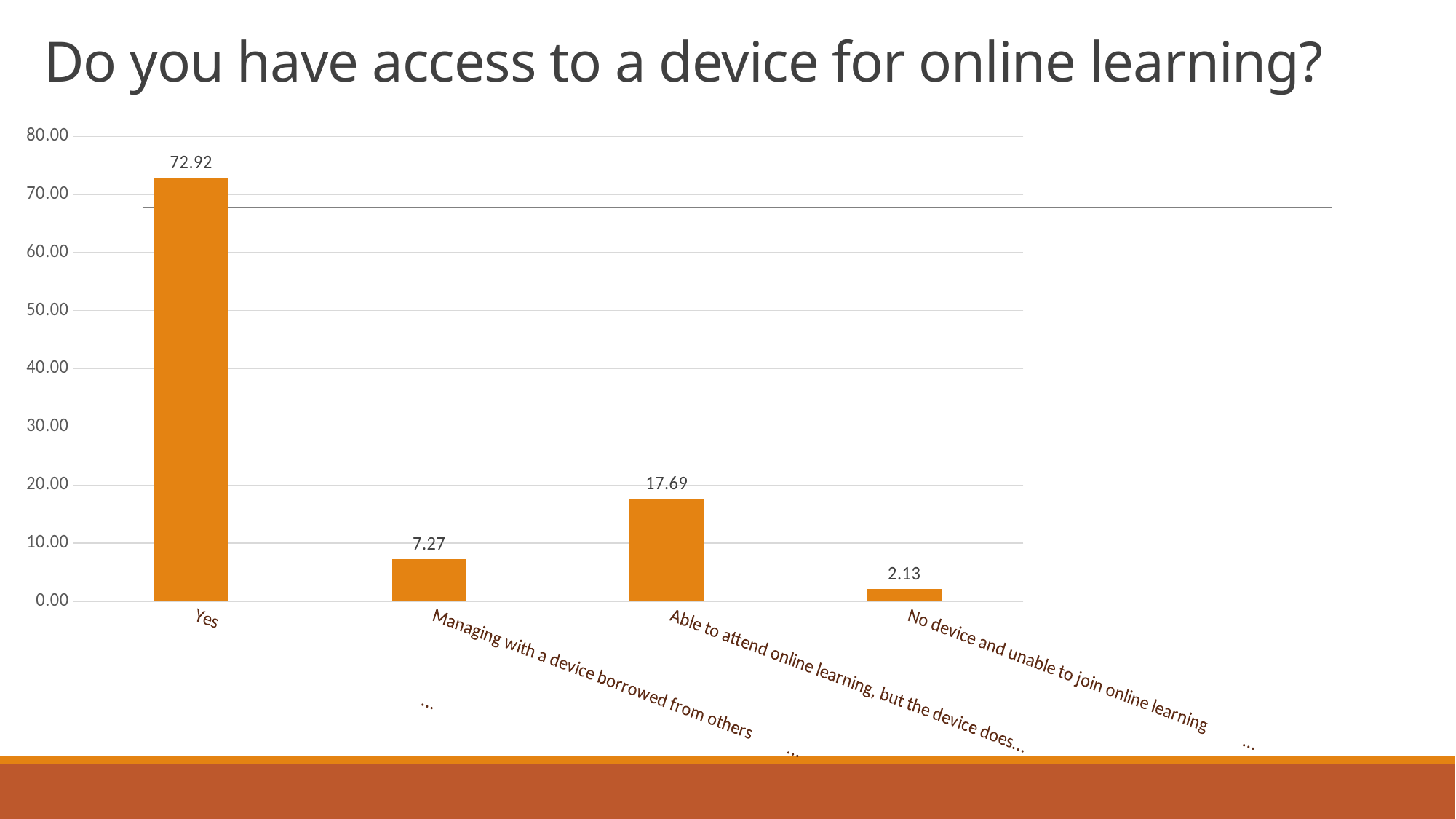
What is the value for "Managing with a device borrowed from others"? 7.27 Which category has the highest value? Yes What is the value for the "Yes" category? 72.92 Is the value for "Yes" greater or less than 70.00? greater What kind of chart is shown on the slide? Bar chart What is the difference between the values for "Yes" and "No device and unable to join online learning"? 70.79 Which is larger: the value for "Managing with a device borrowed from others" or the value for "Able to attend online learning, but the device does..."? Able to attend online learning, but the device does... What is the value for "No device and unable to join online learning"? 2.13 What is the value for the category "Able to attend online learning, but the device does..."? 17.69 What is the difference between the values for "Able to attend online learning, but the device does..." and "Managing with a device borrowed from others"? 10.42 How many categories are shown in the chart? 4 Which category has the lowest value? No device and unable to join online learning